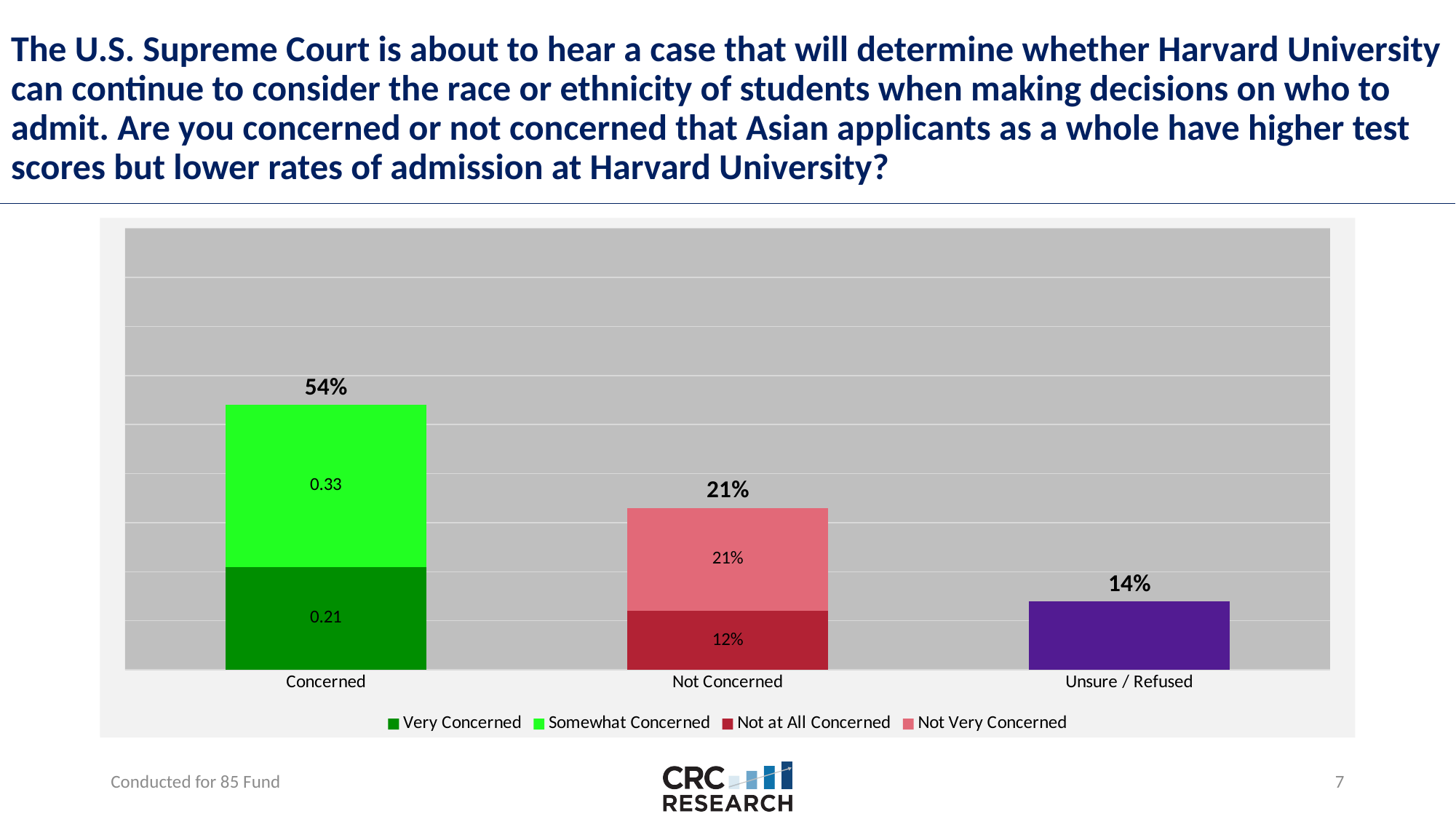
What is the value of the Somewhat Concerned segment in the Concerned bar? 0.33 What is the value of the Not Very Concerned segment in the Not Concerned bar? 21% What value is shown for Unsure / Refused? 14% Which category has the shortest bar? Unsure / Refused What is the value of the Not at All Concerned segment in the Not Concerned bar? 12% How many series does the legend list? 4 How many categories are shown on the x axis? 3 What kind of chart is shown on the slide? Stacked bar chart What is the value of the Very Concerned segment in the Concerned bar? 0.21 Within the Concerned bar, which segment is larger: Very Concerned or Somewhat Concerned? Somewhat Concerned What total is printed above the Concerned bar? 54% Which category has the tallest bar? Concerned